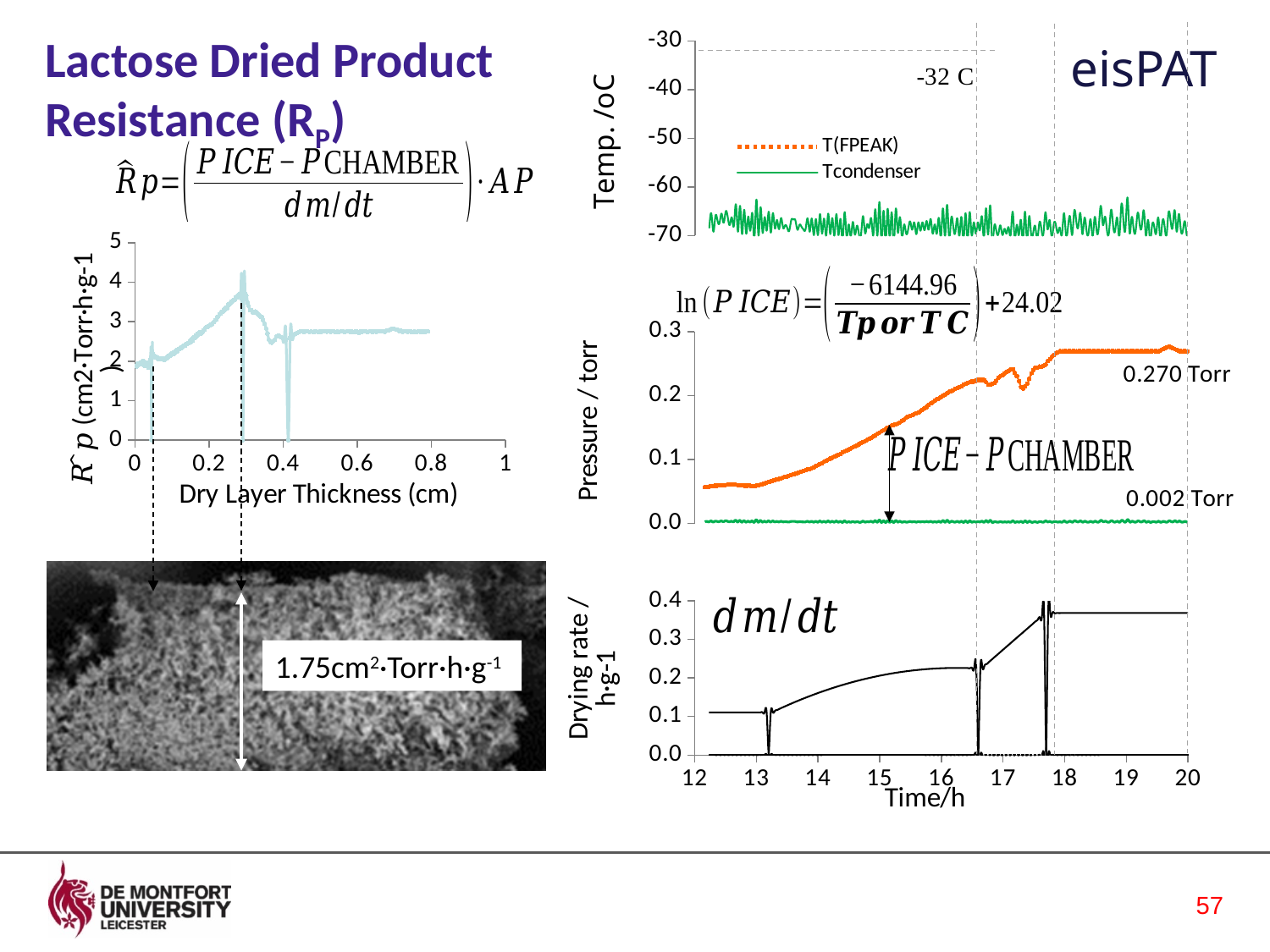
On the left-hand chart, what is the label of the x axis? Dry Layer Thickness (cm) What kind of chart is the left-hand chart of Rp against Dry Layer Thickness? line chart On the top-right temperature chart, is the Tcondenser value greater or less than -60? less On the left-hand chart, is the value of Rp at a dry layer thickness of 0.8 cm greater or less than 3? less On the left-hand chart, is the value of Rp at a dry layer thickness of 0.6 cm greater or less than 2? greater On the middle-right pressure chart, what pressure value is labelled for the green chamber pressure line? 0.002 Torr On the middle-right pressure chart, what is the difference between the labelled 0.270 Torr and 0.002 Torr values? 0.268 Torr On the middle-right pressure chart, what pressure value is labelled at the end of the orange P ICE line? 0.270 Torr On the middle-right pressure chart, does the orange P ICE line rise or fall between 13 h and 18 h? rise How many series does the legend of the top-right temperature chart list? 2